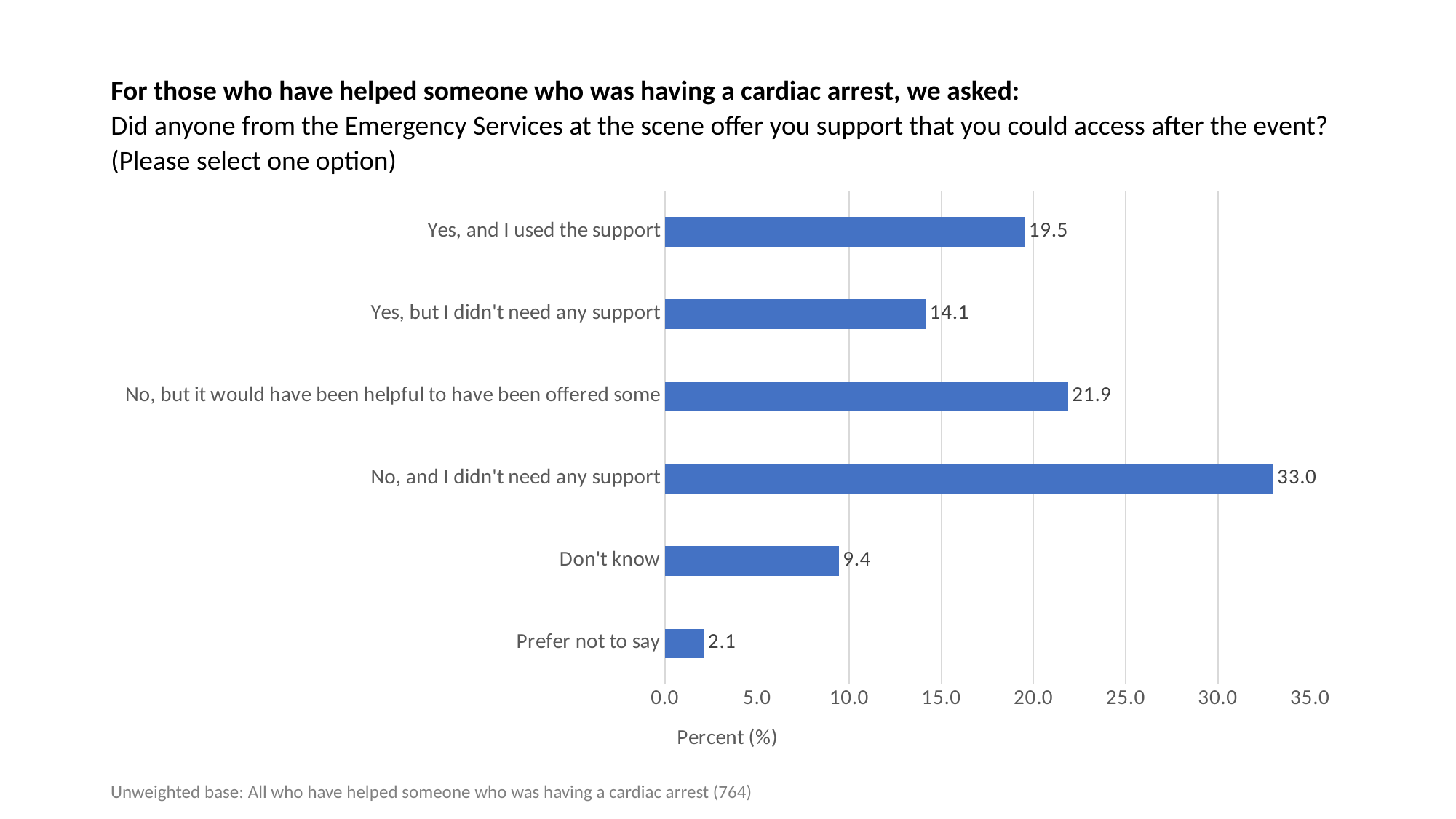
What is the difference between "No, and I didn't need any support" and "Yes, and I used the support"? 13.5 What is the label of the horizontal axis? Percent (%) What kind of chart is shown on the slide? bar chart How many categories are shown in the chart? 6 Which category has the lowest value? Prefer not to say Which is larger: "Yes, but I didn't need any support" or "No, but it would have been helpful to have been offered some"? No, but it would have been helpful to have been offered some Is the value for "Yes, but I didn't need any support" greater or less than 15.0? less Which category has the highest value? No, and I didn't need any support What is the unweighted base size stated below the chart? 764 What is the value for "No, but it would have been helpful to have been offered some"? 21.9 What is the value for "Don't know"? 9.4 What is the value for "Yes, and I used the support"? 19.5